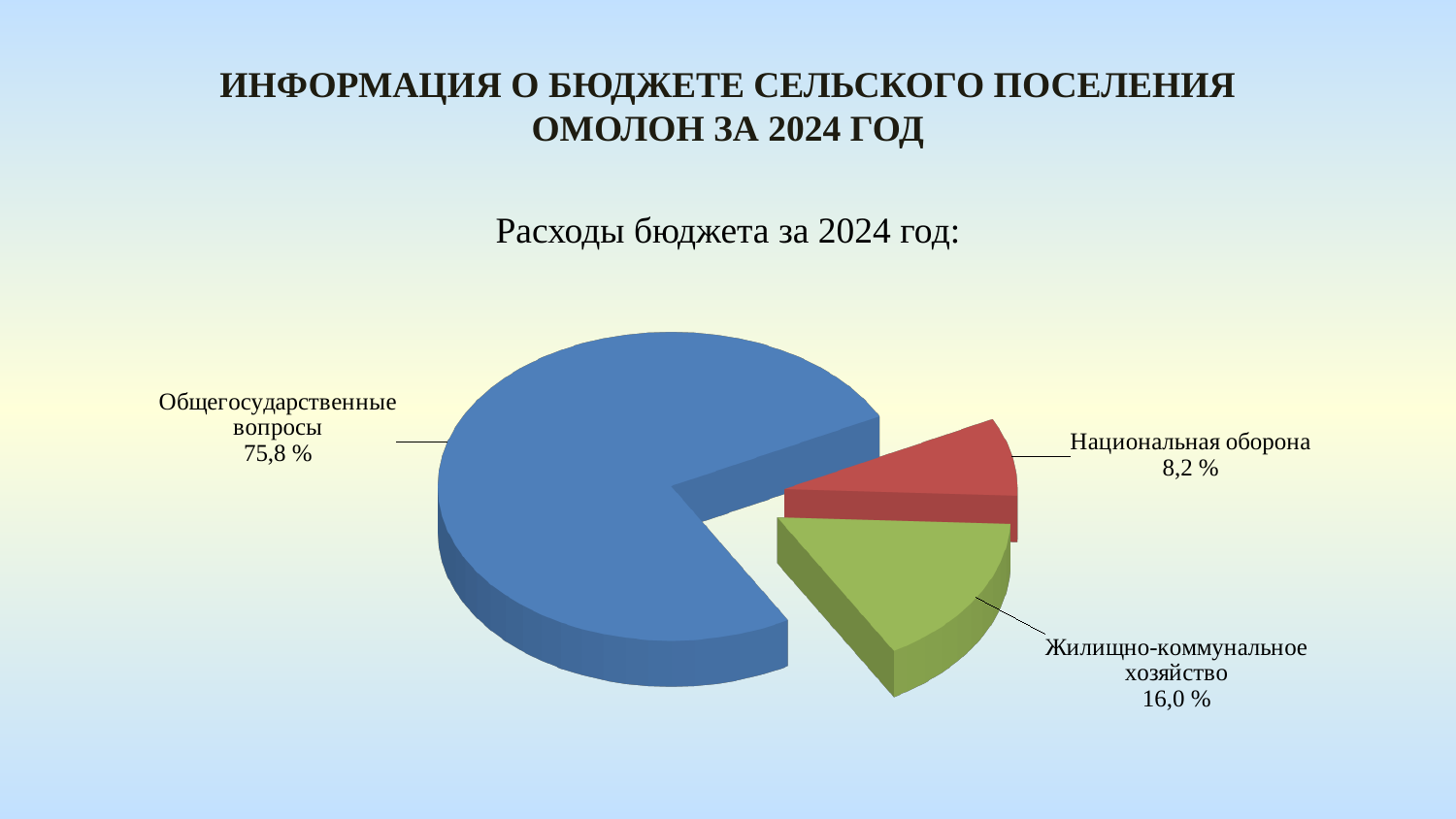
What is the difference in percentage points between Общегосударственные вопросы and Жилищно-коммунальное хозяйство? 59,8 What share of the pie does Общегосударственные вопросы have? 75,8 % What colour is the slice for Общегосударственные вопросы? Blue Which category has the largest share of the pie? Общегосударственные вопросы How many categories are shown in the pie chart? 3 What share of the pie does Национальная оборона have? 8,2 % What kind of chart is shown on the slide? Pie chart Which category has the smallest share of the pie? Национальная оборона What share of the pie does Жилищно-коммунальное хозяйство have? 16,0 % What is the heading above the chart? Расходы бюджета за 2024 год: Which is larger, the share for Жилищно-коммунальное хозяйство or the share for Национальная оборона? Жилищно-коммунальное хозяйство What is the difference in percentage points between Жилищно-коммунальное хозяйство and Национальная оборона? 7,8